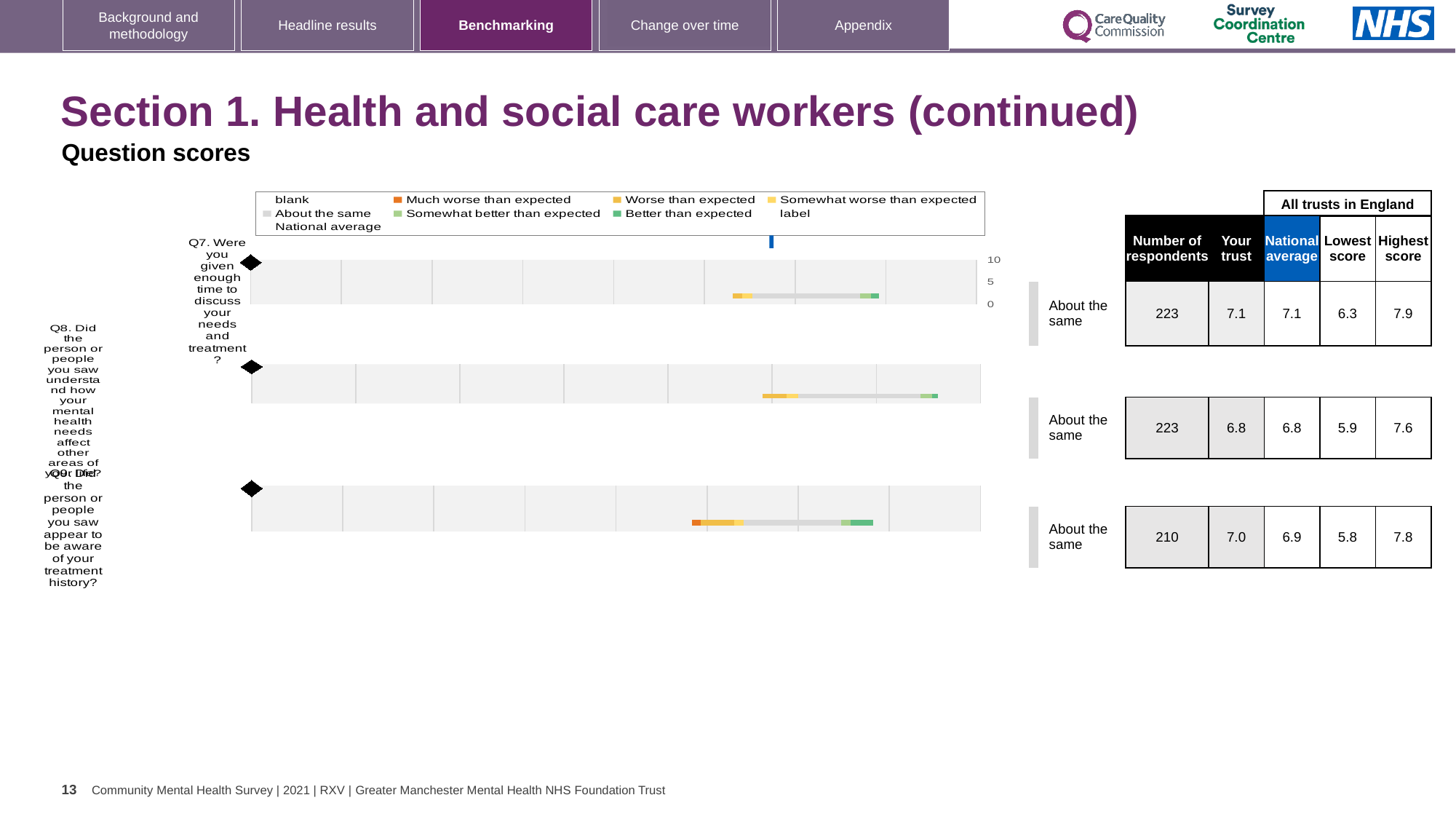
For Q7 (time to discuss needs and treatment), what is the 'Your trust' score shown in the table? 7.1 What benchmark category label is shown next to the Q8 chart? About the same Which question has the highest 'Your trust' score on this slide? Q7 Which question has the lowest 'Lowest score' value on this slide? Q9 For Q7, what is the difference between the 'Your trust' score and the lowest score? 0.8 For Q9, which is larger: the 'Your trust' score or the national average? Your trust How many questions are charted on this slide? 3 For Q8, what is the highest score among all trusts in England? 7.6 How many respondents are listed for Q8 (understand how mental health needs affect other areas of life)? 223 What kind of chart is used to show the question scores? Bar chart For Q9, what is the difference between the highest score and the lowest score? 2.0 For Q9 (aware of your treatment history), what is the national average score? 6.9